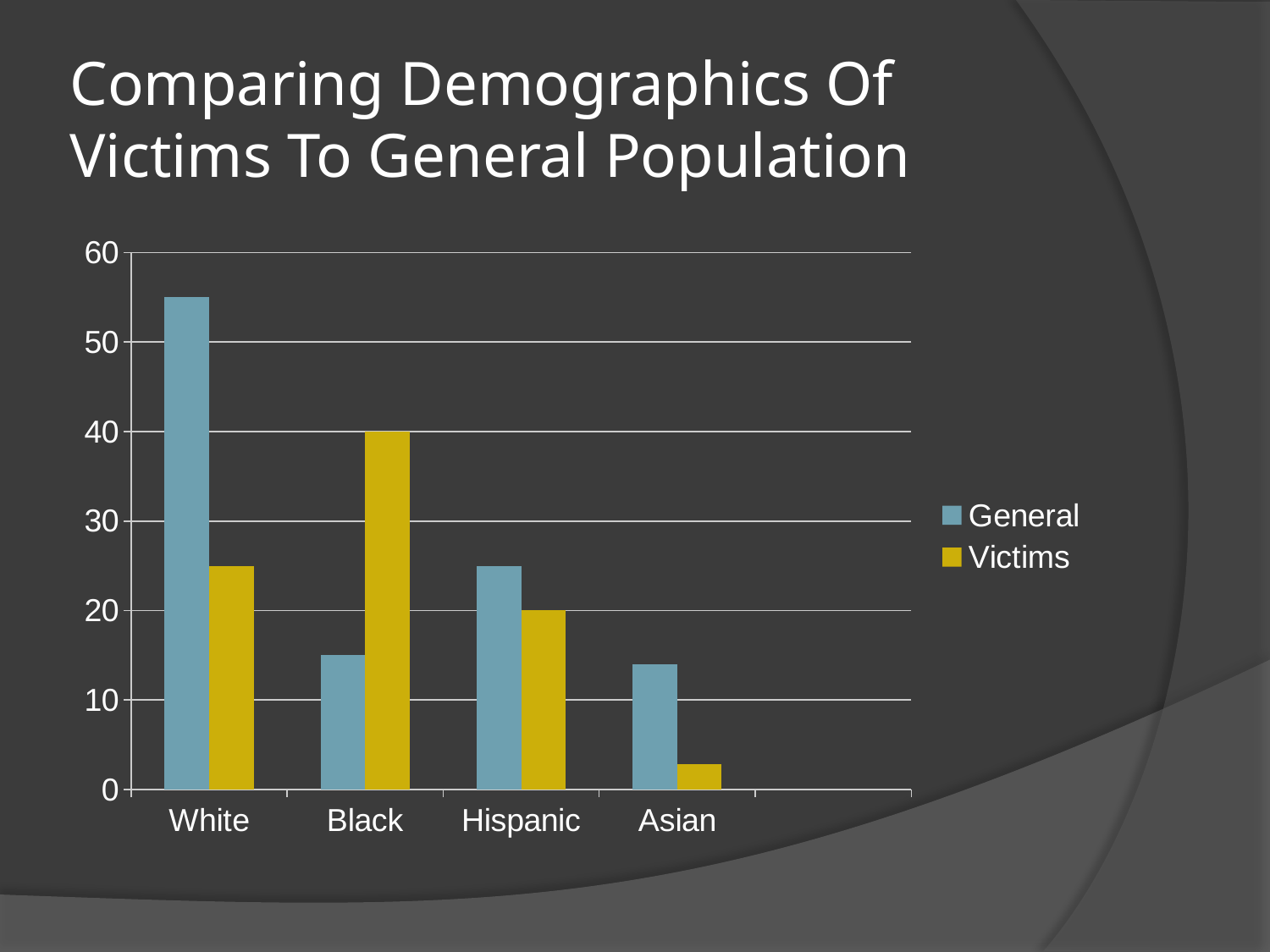
What is the Victims value for Hispanic? 20 Is the Victims value for Asian greater or less than 10? less For Black, which series has the larger value, General or Victims? Victims How many series does the legend list? 2 Which category has the highest Victims value? Black Which category has the lowest Victims value? Asian What is the Victims value for Black? 40 How many categories are shown on the x axis? 4 What type of chart is shown on the slide? bar chart Which category has the highest General value? White What is the difference between the Victims value for Black and the Victims value for Hispanic? 20 Is the General value for White greater or less than 50? greater